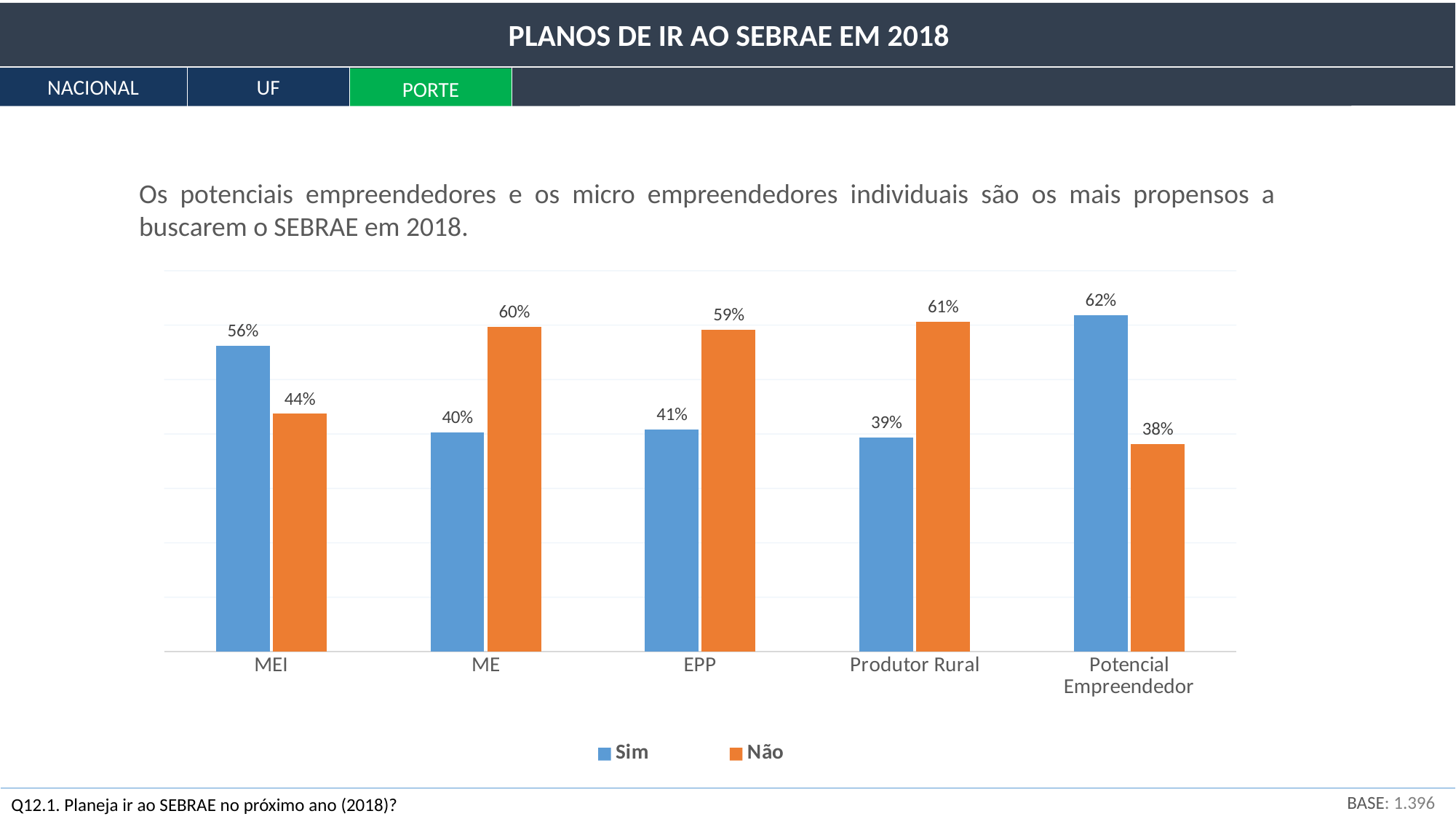
Which category has the lowest 'Sim' value? Produtor Rural How many categories are shown on the x axis? 5 What is the difference between the 'Não' and 'Sim' values for EPP? 18% How many series does the legend list? 2 What is the 'Não' value for Produtor Rural? 61% Which category has the highest 'Sim' value? Potencial Empreendedor What colour are the 'Não' bars? Orange For MEI, which is larger, 'Sim' or 'Não'? Sim What kind of chart is shown on the slide? Bar chart What is the 'Sim' value for MEI? 56% What is the 'Sim' value for Potencial Empreendedor? 62% What is the 'Não' value for ME? 60%